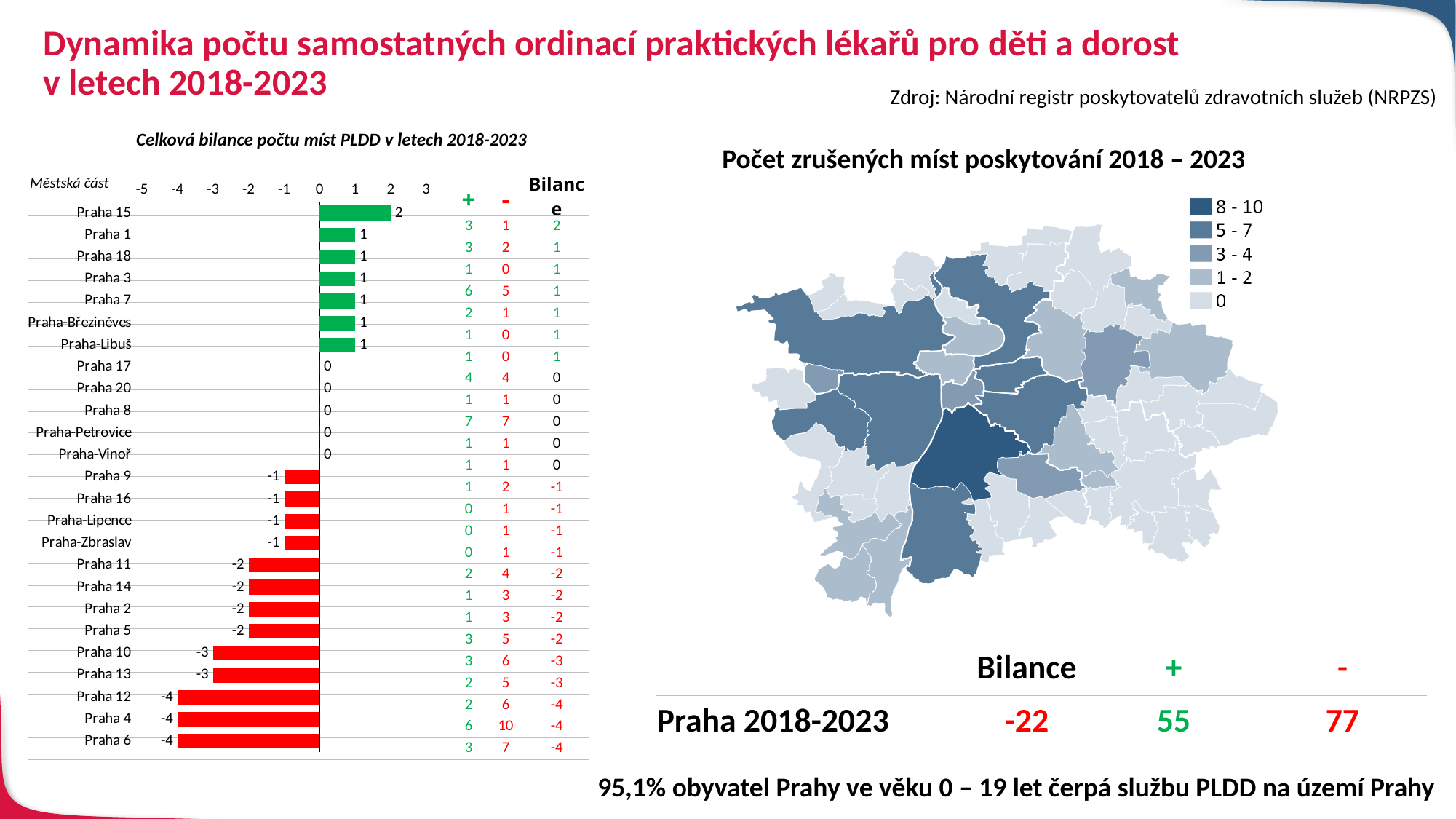
In the chart 'Celková bilance počtu míst PLDD v letech 2018-2023', what colour are the bars with negative values? red In the chart 'Celková bilance počtu míst PLDD v letech 2018-2023', what is the difference between the values for Praha 15 and Praha 6? 6 In the chart 'Celková bilance počtu míst PLDD v letech 2018-2023', which is larger, the value for Praha 1 or the value for Praha 9? Praha 1 In the chart 'Celková bilance počtu míst PLDD v letech 2018-2023', what is the value for Praha 17? 0 In the chart 'Celková bilance počtu míst PLDD v letech 2018-2023', what is the value for Praha-Zbraslav? -1 How many districts are listed in the chart 'Celková bilance počtu míst PLDD v letech 2018-2023'? 25 In the chart 'Celková bilance počtu míst PLDD v letech 2018-2023', what is the value for Praha 15? 2 In the chart 'Celková bilance počtu míst PLDD v letech 2018-2023', what is the value for Praha 10? -3 In the chart 'Celková bilance počtu míst PLDD v letech 2018-2023', which district has the highest value? Praha 15 In the chart 'Celková bilance počtu míst PLDD v letech 2018-2023', what is the lowest value shown? -4 In the chart 'Celková bilance počtu míst PLDD v letech 2018-2023', how many districts have a value of -4? 3 What type of chart is 'Celková bilance počtu míst PLDD v letech 2018-2023'? bar chart